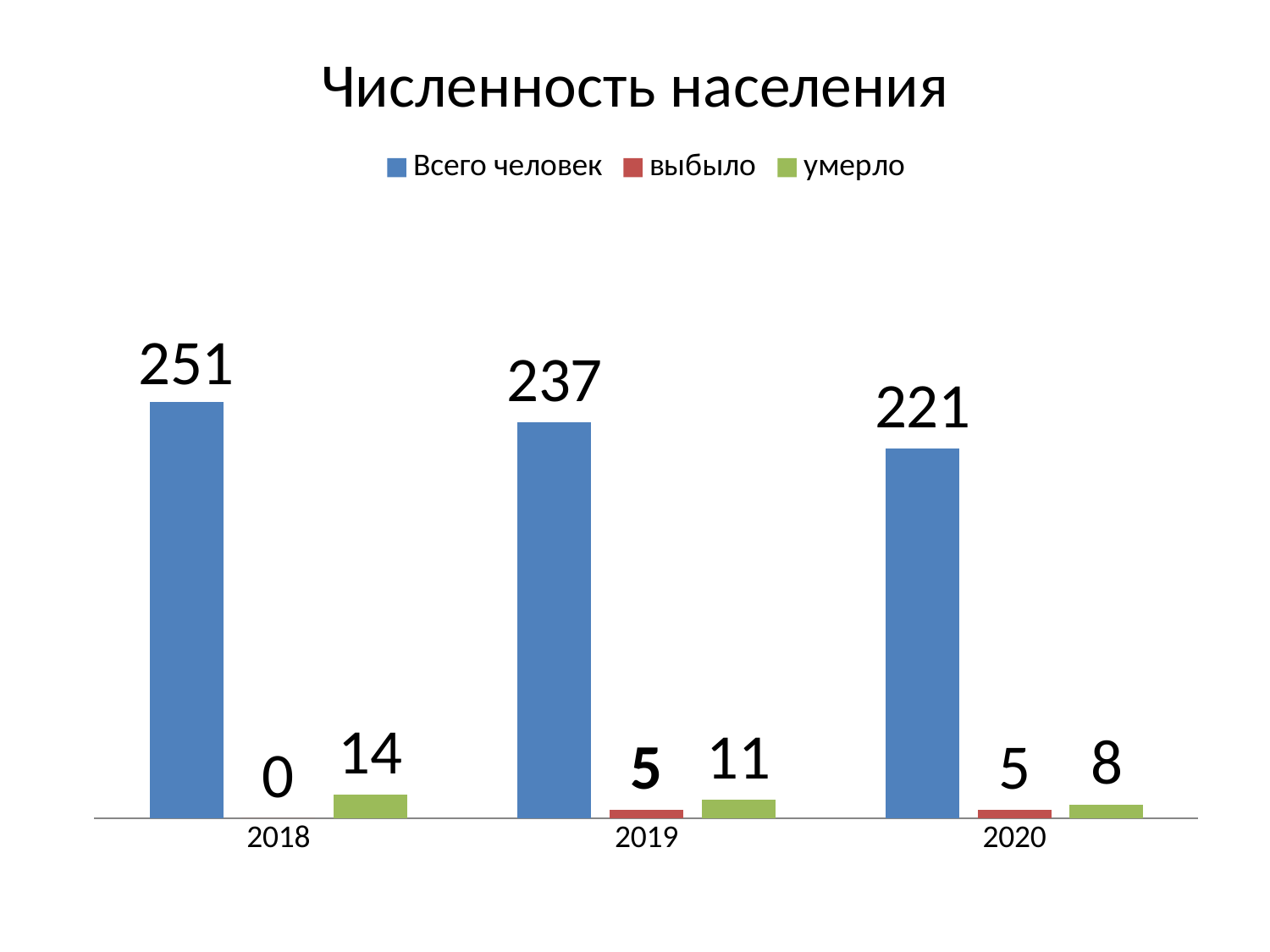
How many series does the legend list? 3 What is the value of "Всего человек" for 2018? 251 How many years are shown on the x axis? 3 What kind of chart is this? bar chart What is the value of "выбыло" for 2020? 5 What is the value of "выбыло" for 2018? 0 In which year is "Всего человек" the lowest? 2020 Does "Всего человек" rise or fall from 2018 to 2020? fall What is the difference between "Всего человек" in 2018 and 2020? 30 Which is larger: "умерло" in 2019 or "умерло" in 2020? 2019 In which year is "умерло" the highest? 2018 What is the value of "умерло" for 2019? 11